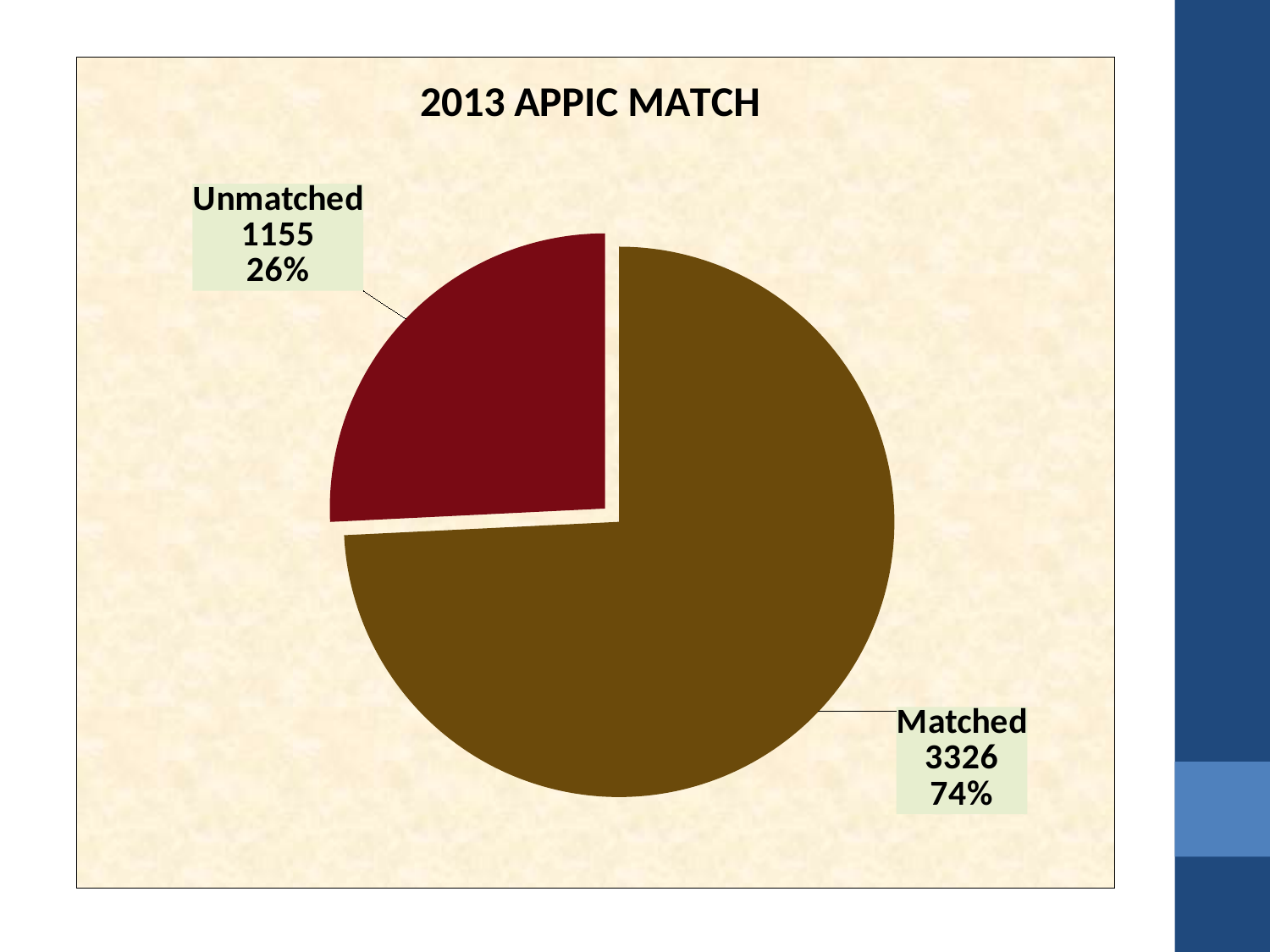
What is the difference between the Matched and Unmatched values? 2171 What is the total of the Matched and Unmatched values? 4481 What kind of chart is shown on the slide? pie chart What is the value for Unmatched? 1155 What share of the pie does the Unmatched slice represent? 26% What is the title of the chart? 2013 APPIC MATCH What is the value for Matched? 3326 Which is larger, Matched or Unmatched? Matched Which category has the smallest slice? Unmatched How many slices does the pie chart have? 2 What share of the pie does the Matched slice represent? 74% Which category has the largest slice? Matched